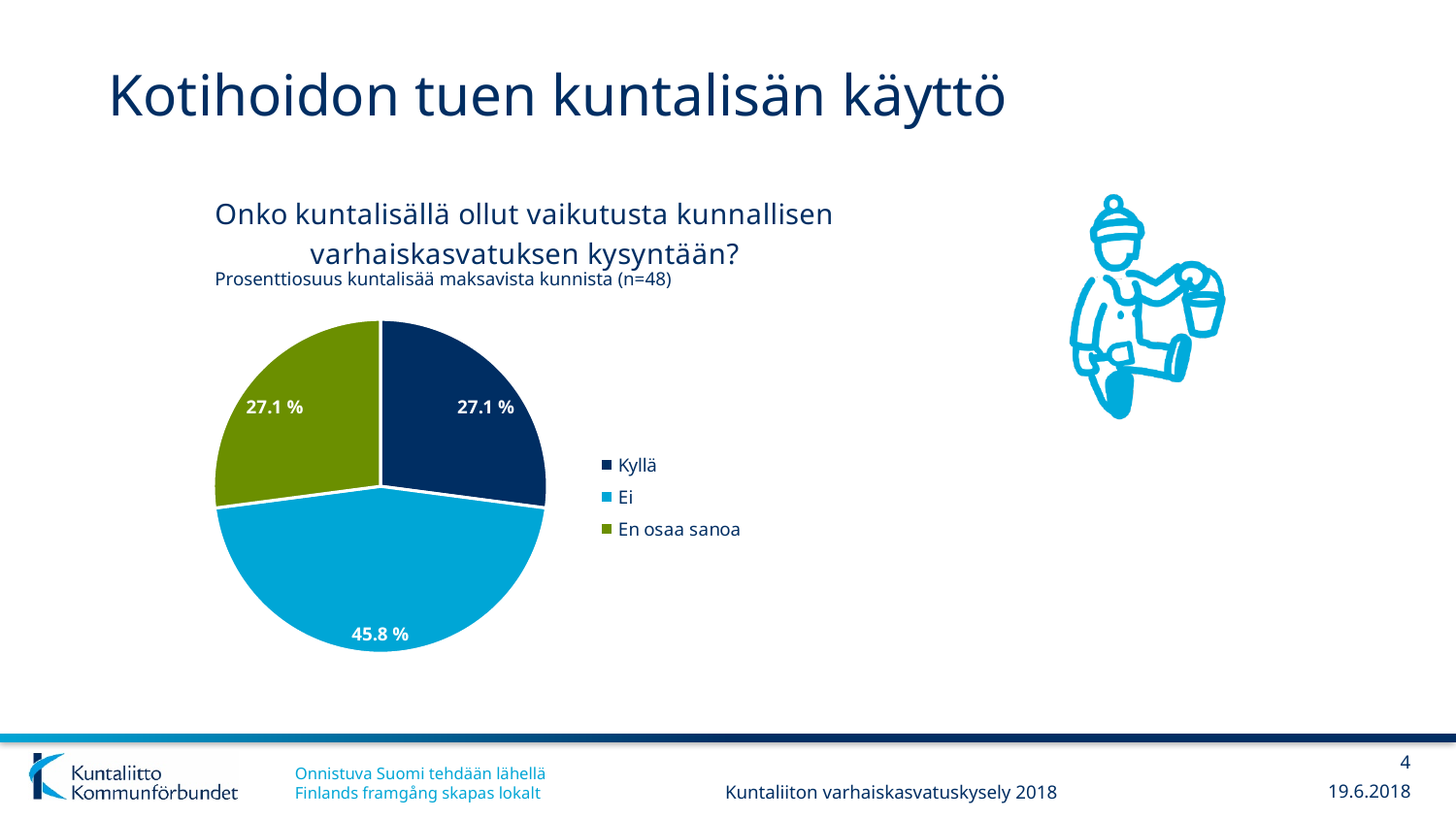
What is the difference in percentage points between the "Ei" slice and the "Kyllä" slice? 18.7 What percentage of the pie is labelled for the "Ei" slice? 45.8 % Which legend entry is shown in green? En osaa sanoa Which is larger, the share for "Ei" or the share for "Kyllä"? Ei What is the sample size (n) stated below the chart title? 48 How many entries does the legend list? 3 What kind of chart is shown on the slide? pie chart How many slices does the pie chart have? 3 Is the share for "Ei" greater or less than 50 %? less Which category has the largest share of the pie? Ei What percentage is shown for the "Kyllä" slice? 27.1 % What percentage is shown for the "En osaa sanoa" slice? 27.1 %